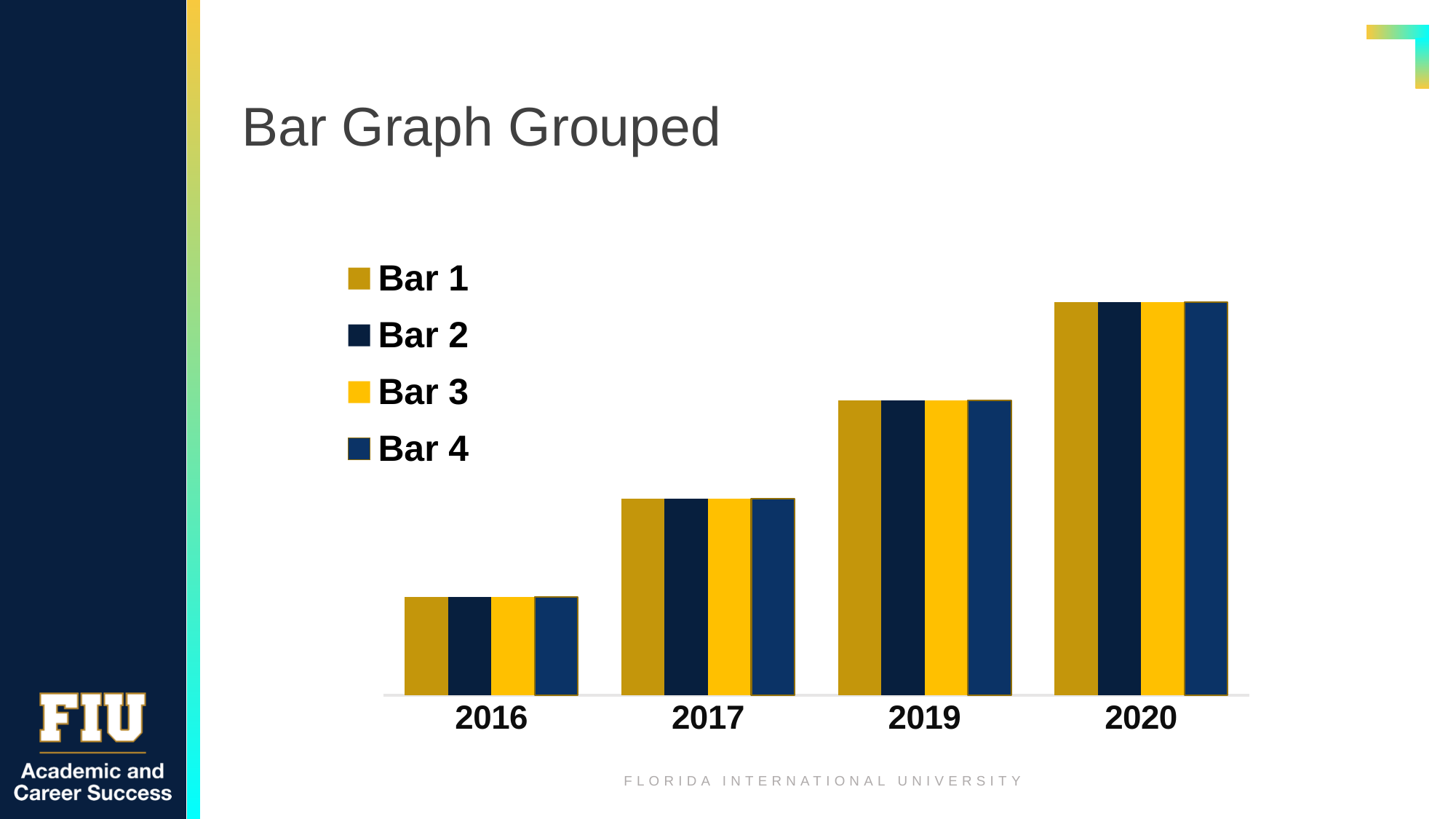
Which year has the tallest bars in the chart? 2020 How many categories are shown along the x axis of the chart? 4 Is the Bar 1 value larger in 2017 or in 2019? 2019 Which year has the shortest bars in the chart? 2016 How many series does the chart's legend list? 4 Which year label appears third from the left on the x axis? 2019 Is the Bar 2 value larger in 2019 or in 2017? 2019 What is the title of the slide containing the chart? Bar Graph Grouped Is the Bar 4 value larger in 2016 or in 2020? 2020 Do the values in the chart rise or fall from 2016 to 2020? rise What kind of chart is shown on the slide? bar chart What are the names of the series listed in the chart's legend? Bar 1, Bar 2, Bar 3, Bar 4